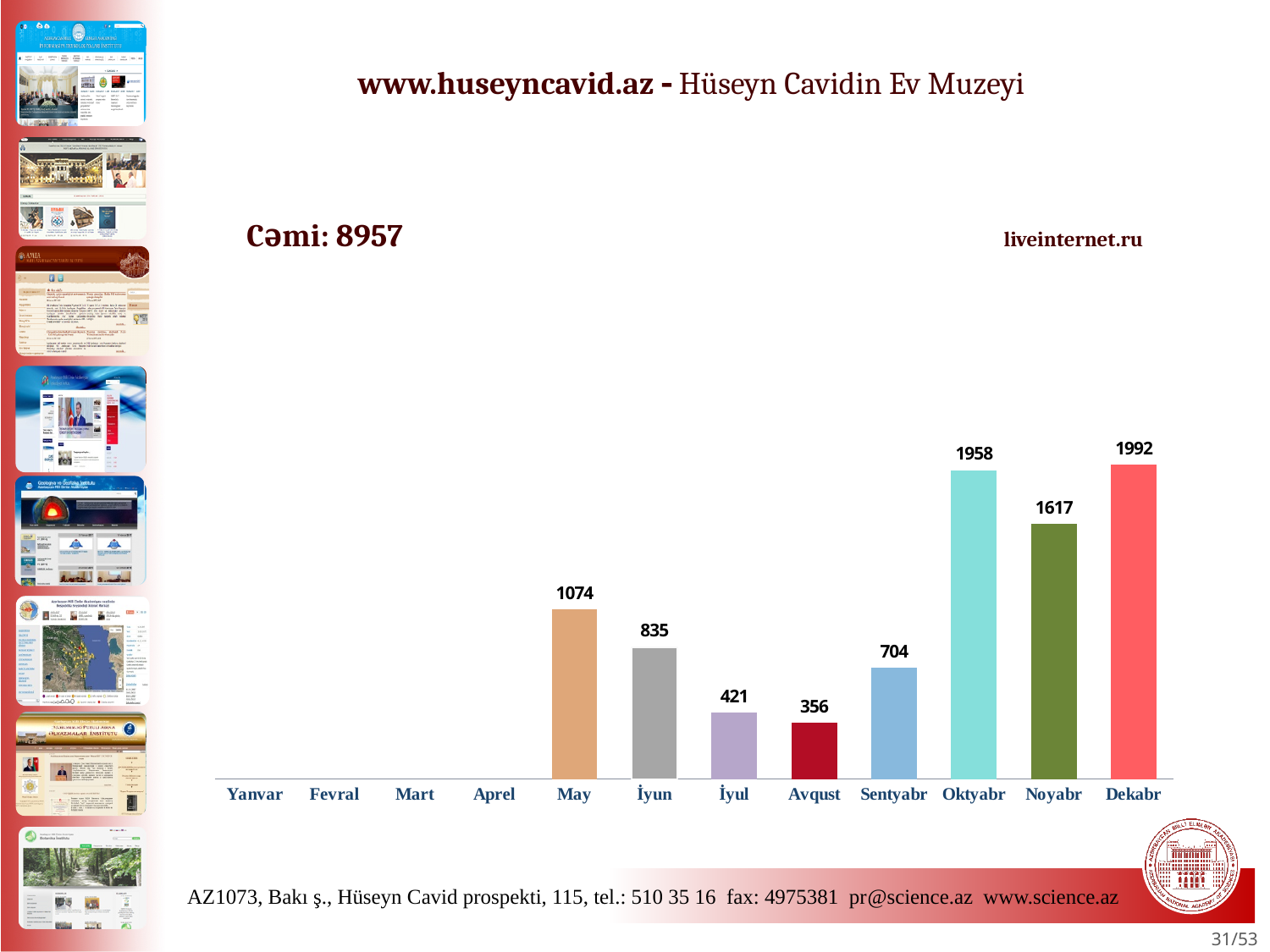
What is the difference between the values for İyun and İyul? 414 How many month categories are shown on the x axis? 12 What is the value for Avqust? 356 What is the difference between the values for Dekabr and Noyabr? 375 What is the value for May? 1074 What total (Cəmi) is stated on the slide? 8957 Among the months with a plotted bar, which has the lowest value? Avqust What is the value for Oktyabr? 1958 What is the value for Noyabr? 1617 What kind of chart is shown on the slide? bar chart Which is larger, the value for Sentyabr or the value for İyun? İyun Which month has the highest value? Dekabr